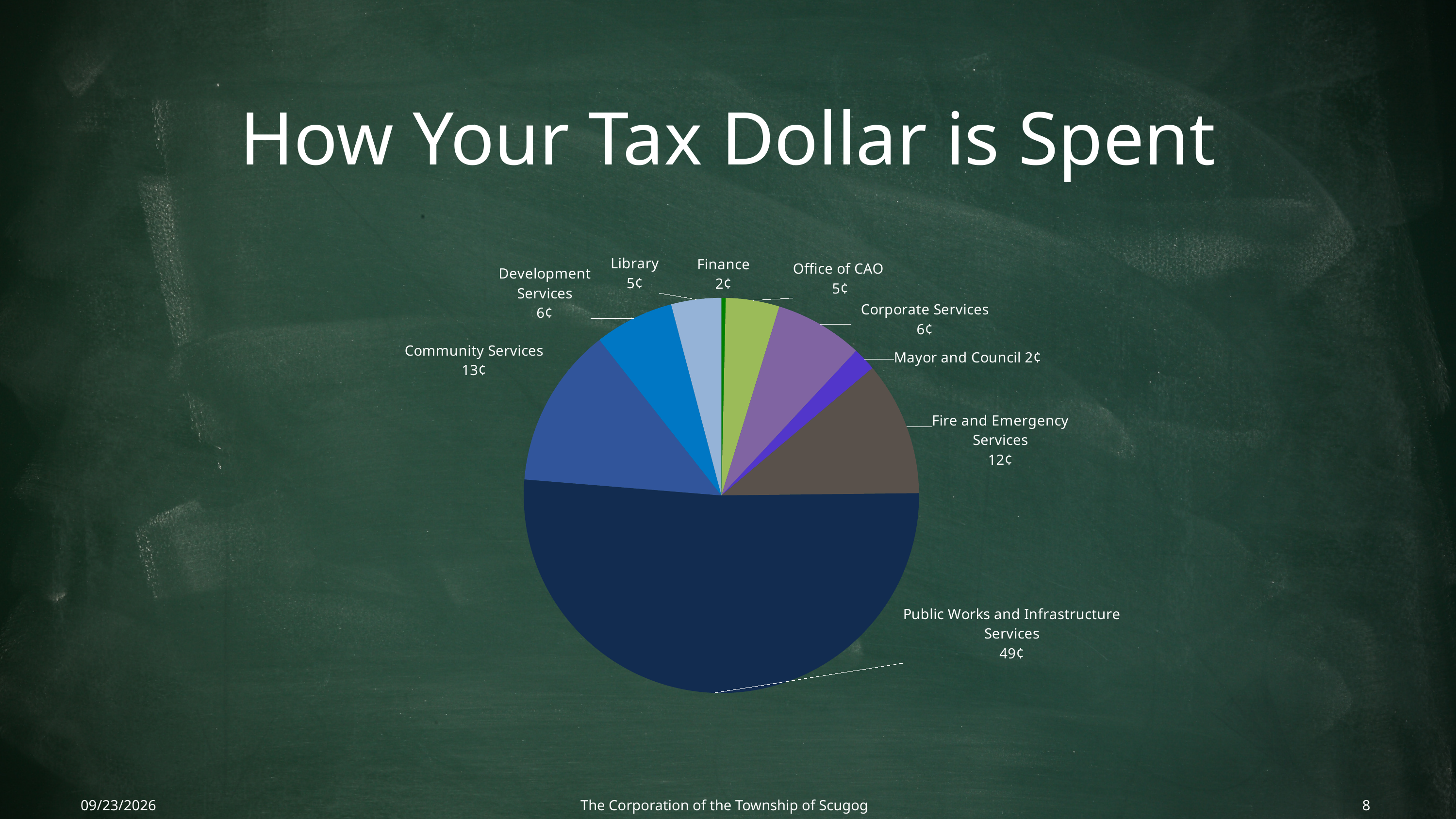
Which category receives the largest share of the tax dollar? Public Works and Infrastructure Services What is the difference between Development Services and Finance? 4¢ What is the difference between Public Works and Infrastructure Services and Community Services? 36¢ Which is larger, Community Services or Fire and Emergency Services? Community Services How many slices does the pie chart have? 9 What is the value shown for Library? 5¢ What kind of chart is shown on the slide? pie chart What is the title of the chart slide? How Your Tax Dollar is Spent What is the value shown for Community Services? 13¢ What share of the pie does Public Works and Infrastructure Services represent? 49¢ How many cents of the tax dollar go to Public Works and Infrastructure Services? 49¢ What is the value shown for Fire and Emergency Services? 12¢